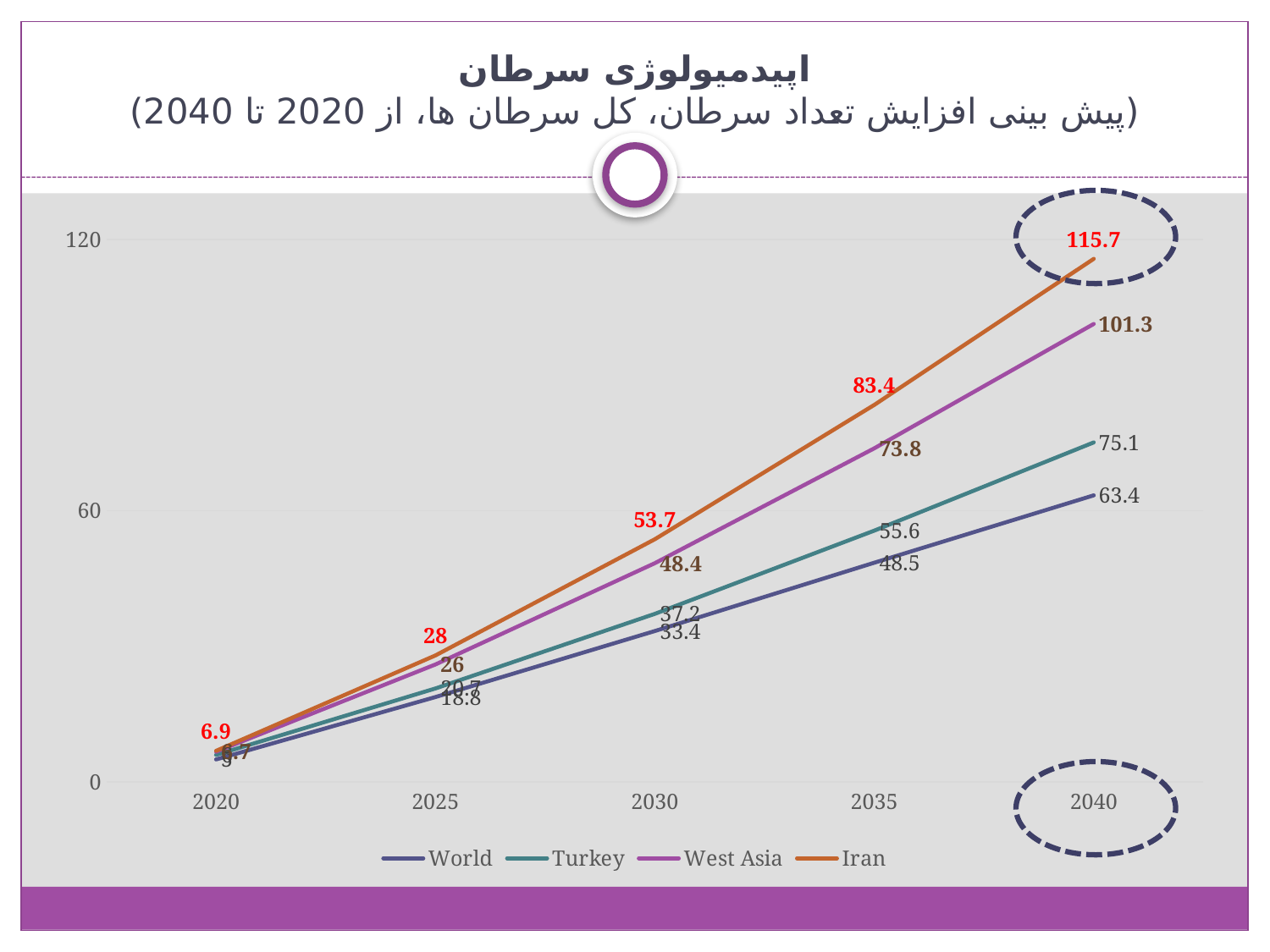
What is the value for West Asia in 2035? 73.8 What is the value for Turkey in 2030? 37.2 Which series has the highest value in 2040? Iran Which series has the lowest value in 2035? World What is the difference between the Iran and West Asia values in 2040? 14.4 What kind of chart is shown on the slide? line chart Which is larger in 2025, the value for Turkey or the value for West Asia? West Asia What is the value for World in 2040? 63.4 What is the value for Iran in 2040? 115.7 How many years are shown on the x axis? 5 How many series does the legend list? 4 Do the values for Iran rise or fall from 2020 to 2040? rise